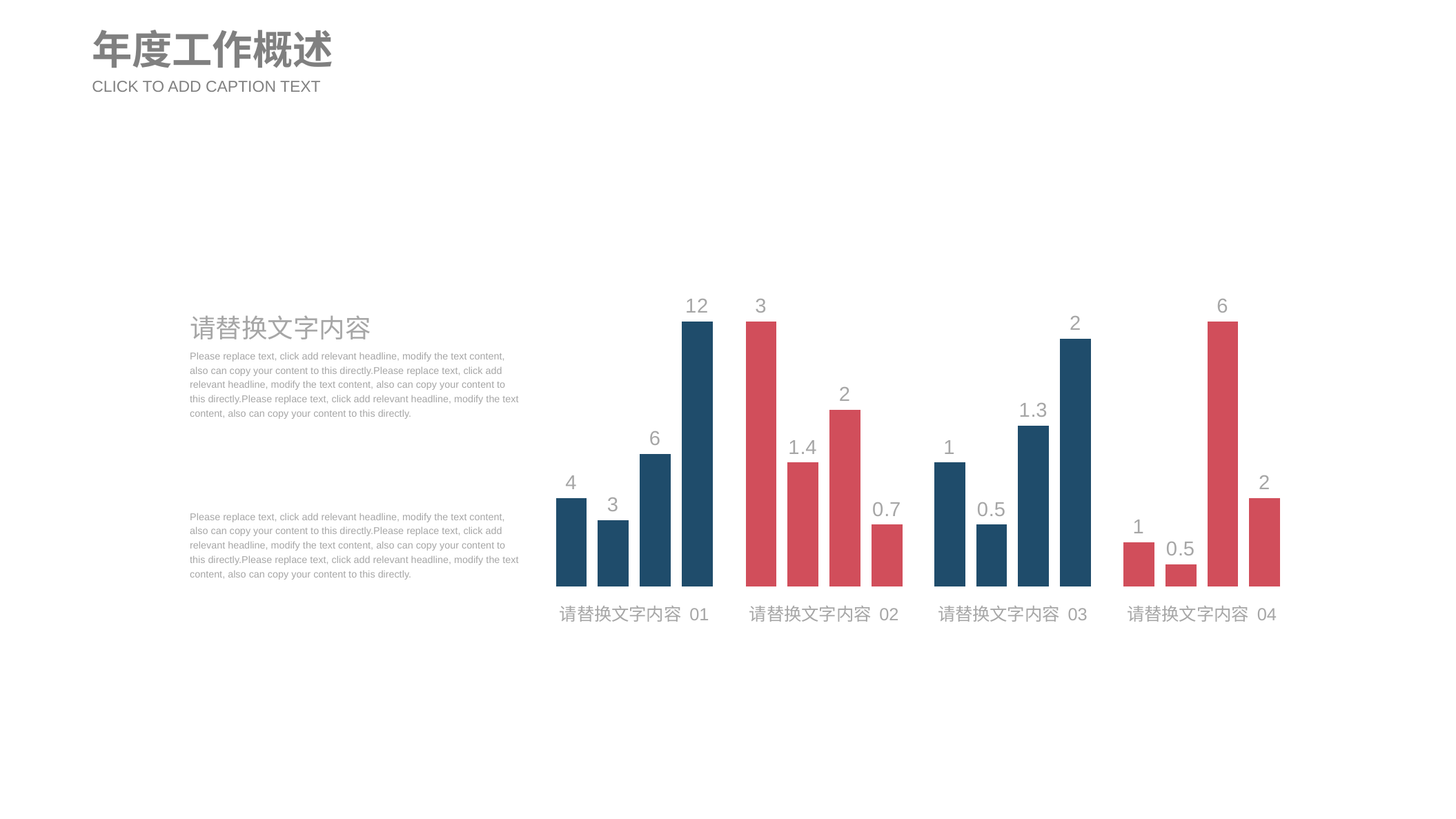
How many bars are in the group labelled 请替换文字内容 03? 4 How many category labels are shown along the bottom of the chart? 4 What is the difference between the highest and lowest labelled values in the group 请替换文字内容 01? 9 In the group labelled 请替换文字内容 03, which is larger: the first bar or the second bar? the first bar (1) What is the value of the first bar in the group labelled 请替换文字内容 02? 3 What is the value of the tallest bar in the group labelled 请替换文字内容 01? 12 What is the value of the tallest bar in the group labelled 请替换文字内容 04? 6 What kind of chart is shown on the slide? bar chart What is the value of the lowest bar in the group labelled 请替换文字内容 02? 0.7 What is the total of the four labelled values in the group 请替换文字内容 04? 9.5 What colour are the bars in the group labelled 请替换文字内容 02? red What is the value of the third bar in the group labelled 请替换文字内容 03? 1.3